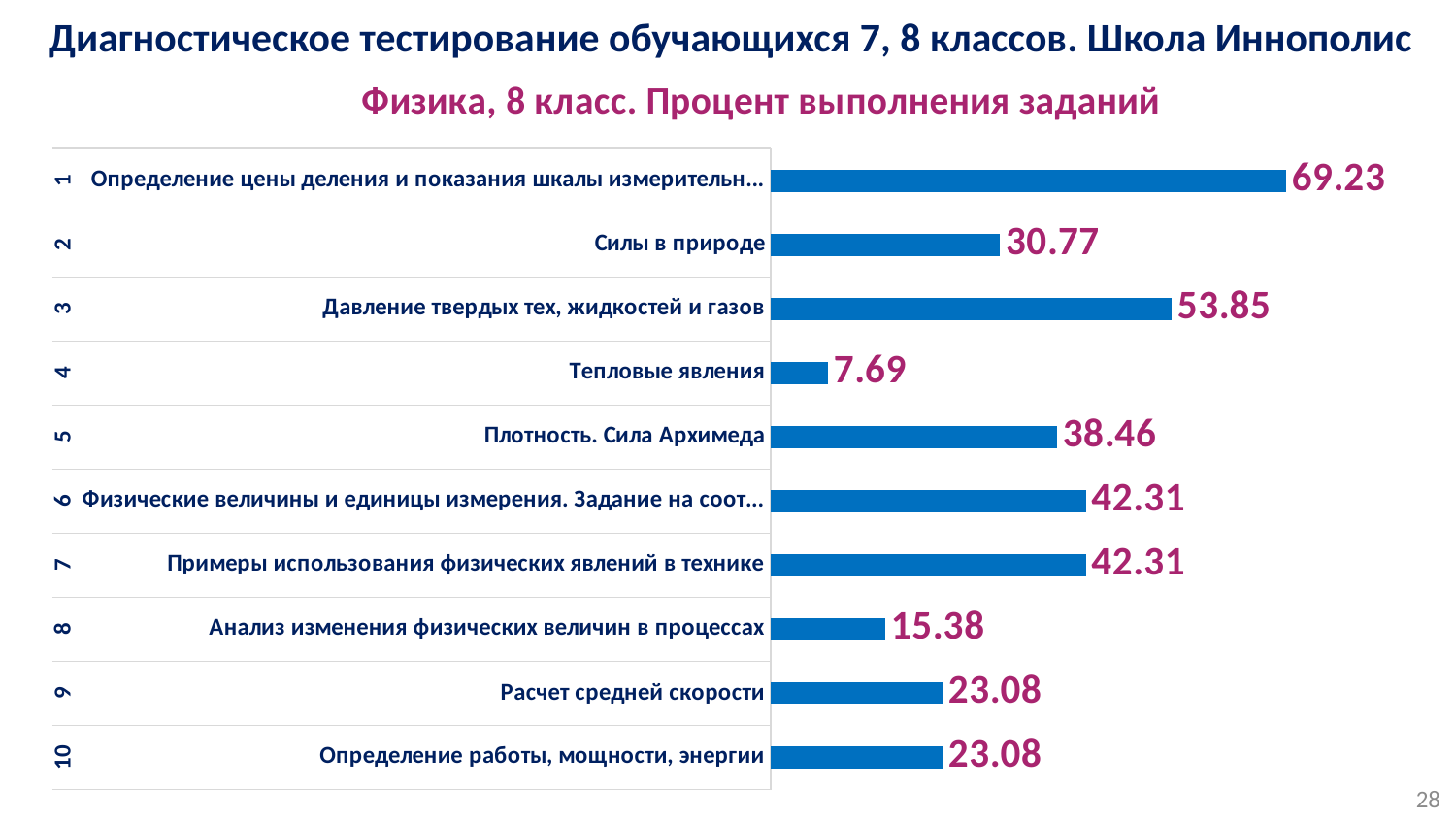
Which category has the highest value? Определение цены деления и показания шкалы измерительн... What is the difference between the values for "Давление твердых тех, жидкостей и газов" and "Силы в природе"? 23.08 Which is larger: the value for "Плотность. Сила Архимеда" or the value for "Анализ изменения физических величин в процессах"? Плотность. Сила Архимеда What is the value for "Расчет средней скорости"? 23.08 What is the value for "Плотность. Сила Архимеда"? 38.46 Which category has the lowest value? Тепловые явления What is the subtitle of the chart? Физика, 8 класс. Процент выполнения заданий What kind of chart is shown on the slide? Bar chart What is the value for "Силы в природе"? 30.77 What is the difference between the values for "Примеры использования физических явлений в технике" and "Определение работы, мощности, энергии"? 19.23 What is the value for "Тепловые явления"? 7.69 How many categories are shown in the chart? 10